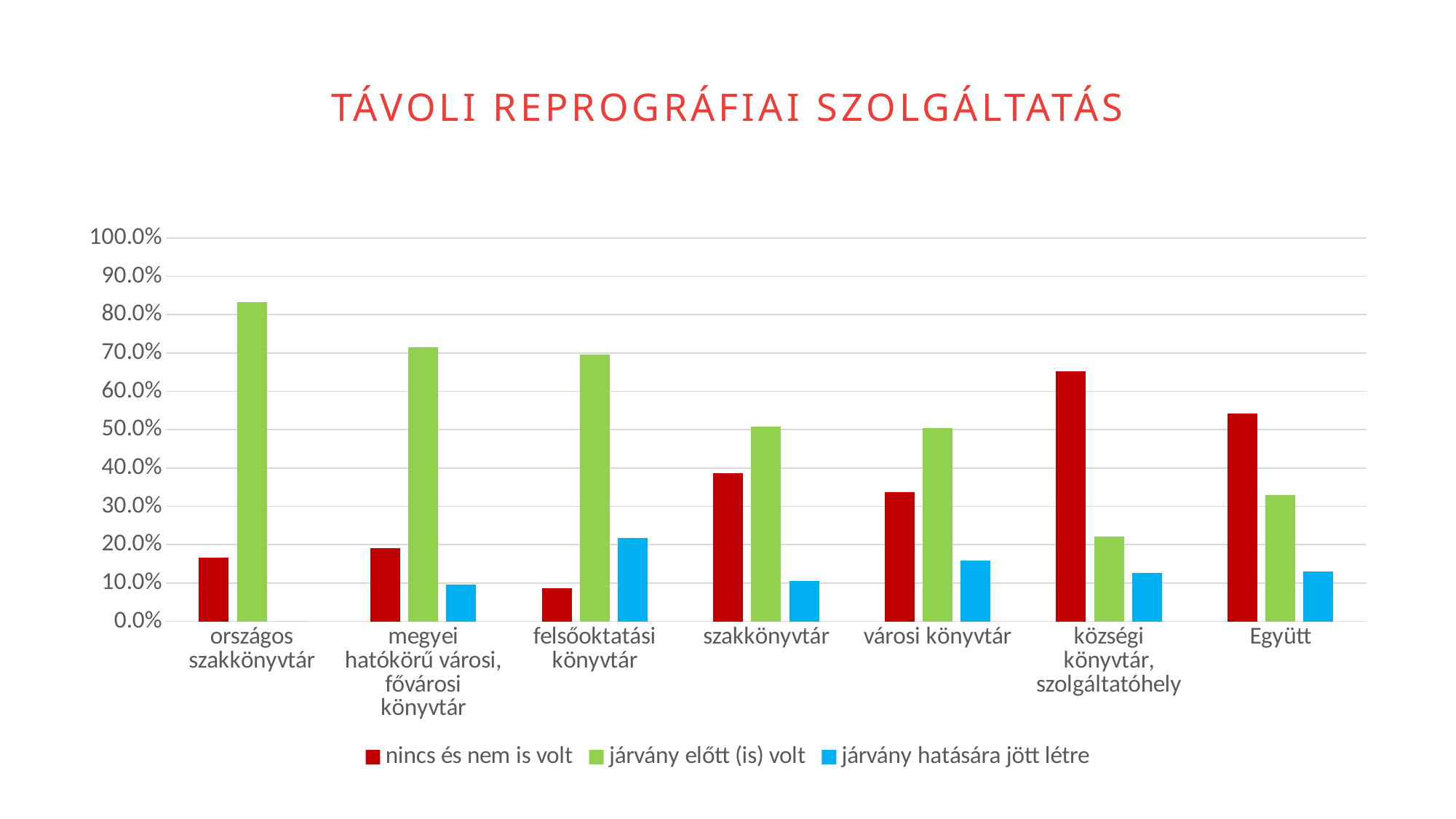
Which category has the lowest value for the series 'nincs és nem is volt'? felsőoktatási könyvtár Which category has the highest value for the series 'járvány hatására jött létre'? felsőoktatási könyvtár For községi könyvtár, szolgáltatóhely, which is larger: 'nincs és nem is volt' or 'járvány előtt (is) volt'? nincs és nem is volt Which category has the highest value for the series 'nincs és nem is volt'? községi könyvtár, szolgáltatóhely What is the title of the chart? TÁVOLI REPROGRÁFIAI SZOLGÁLTATÁS How many series does the legend list? 3 Which category has the highest value for the series 'járvány előtt (is) volt'? országos szakkönyvtár For szakkönyvtár, which is larger: 'nincs és nem is volt' or 'járvány előtt (is) volt'? járvány előtt (is) volt Is the value of 'nincs és nem is volt' for Együtt greater or less than 50.0%? greater Is the value of 'járvány előtt (is) volt' for országos szakkönyvtár greater or less than 80.0%? greater What kind of chart is shown on the slide? bar chart How many library categories are shown on the x axis? 7